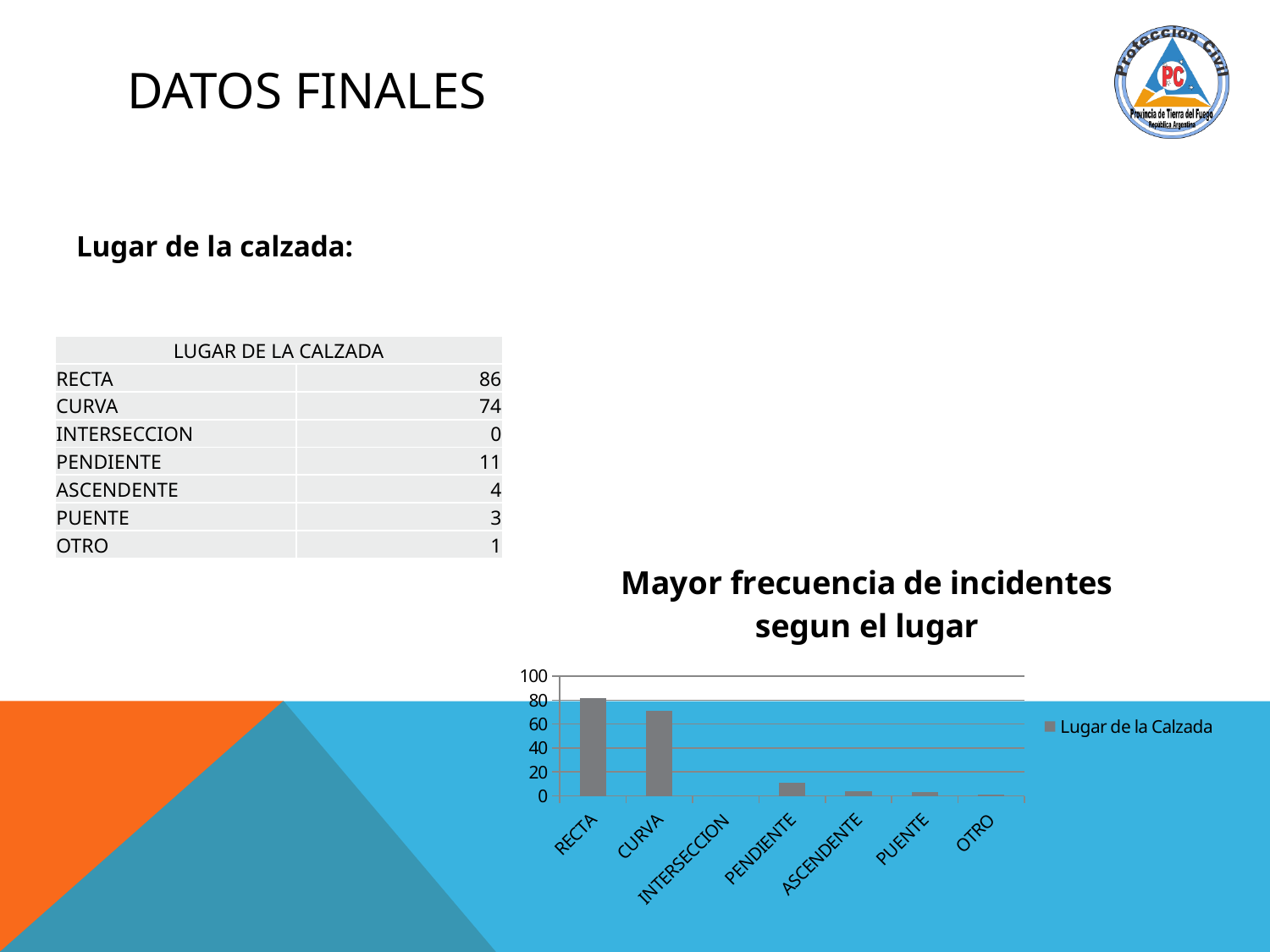
What is the name of the series in the chart legend? Lugar de la Calzada Is the value for CURVA greater or less than 80? less Which category has the highest bar in the chart? RECTA Which is larger, the value for CURVA or the value for PENDIENTE? CURVA What is the value for RECTA, as printed in the table on the slide? 86 What is the title of the chart? Mayor frecuencia de incidentes segun el lugar How many series does the chart legend list? 1 Is the value for PENDIENTE greater or less than 20? less What kind of chart is shown on the slide? bar chart How many categories are shown on the x axis of the chart? 7 Is the value for RECTA greater or less than 80? greater Which category has the lowest value in the chart? INTERSECCION